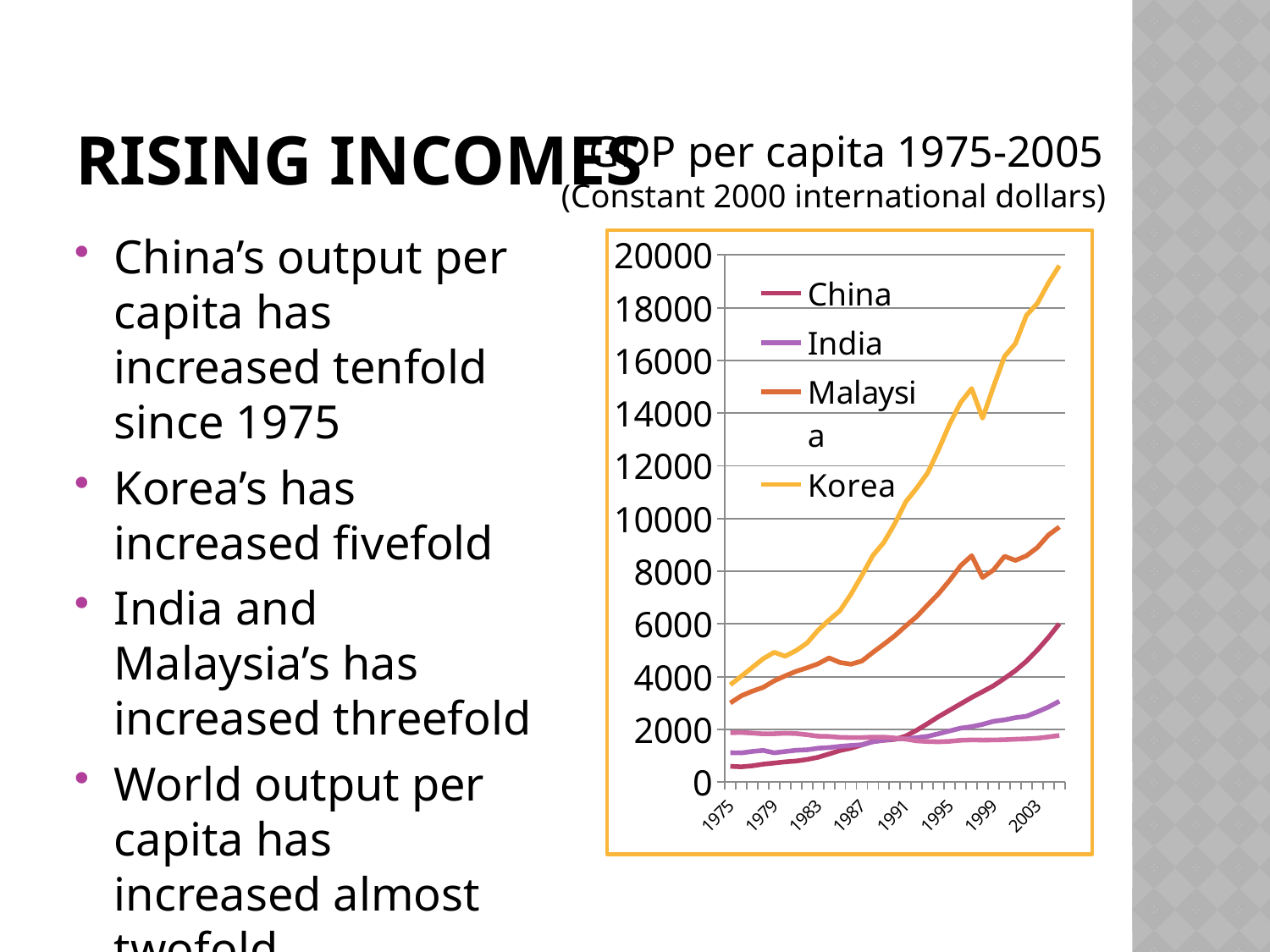
What kind of chart is shown on the slide? line chart What units does the chart's subtitle say the values are in? Constant 2000 international dollars What is the title of the chart? GDP per capita 1975-2005 Does Korea's GDP per capita generally rise or fall from 1975 to 2005? rise Is the value for Malaysia in 2005 greater or less than 8000? greater Is the value for Korea in 2005 greater or less than 18000? greater Which of the legend's countries has the lowest GDP per capita in 1975? China How many series does the chart's legend list? 4 In 2005, which is larger, the value for Malaysia or the value for China? Malaysia Is the value for China in 1975 greater or less than 2000? less Which country has the highest GDP per capita in 2005? Korea